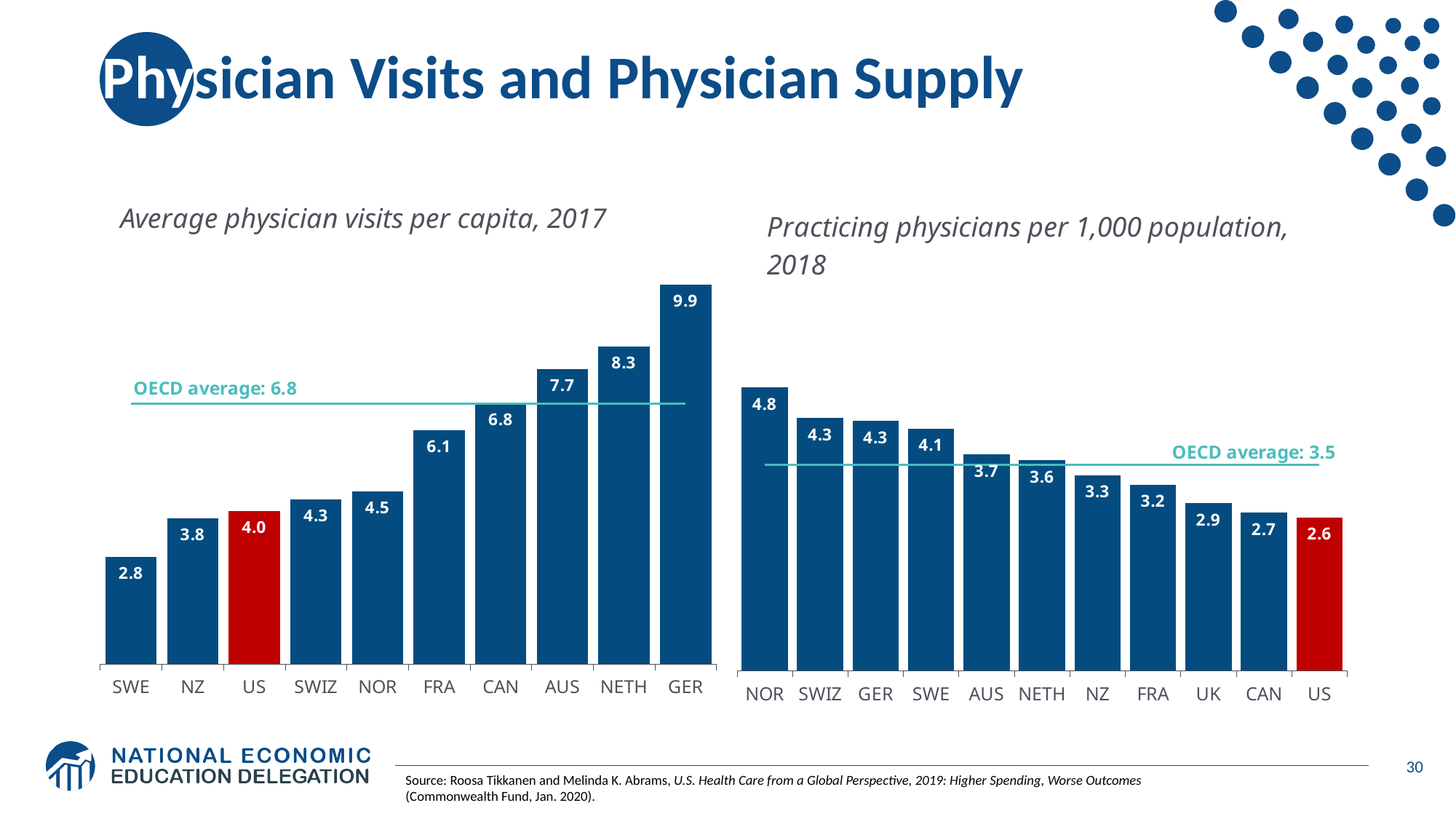
In the 'Practicing physicians per 1,000 population, 2018' chart, do the values rise or fall from left to right? Fall In the 'Average physician visits per capita, 2017' chart, which is larger, the value for FRA or the value for NOR? FRA How many countries are shown in the 'Average physician visits per capita, 2017' chart? 10 What OECD average is marked on the 'Average physician visits per capita, 2017' chart? 6.8 In the 'Average physician visits per capita, 2017' chart, what is the difference between GER and US? 5.9 In the 'Practicing physicians per 1,000 population, 2018' chart, what is the value for US? 2.6 In the 'Practicing physicians per 1,000 population, 2018' chart, what is the difference between NOR and US? 2.2 In the 'Average physician visits per capita, 2017' chart, which country has the lowest value? SWE What kind of chart is the 'Average physician visits per capita, 2017' chart? Bar chart In the 'Practicing physicians per 1,000 population, 2018' chart, which country has the highest value? NOR How many countries are shown in the 'Practicing physicians per 1,000 population, 2018' chart? 11 In the 'Average physician visits per capita, 2017' chart, what is the value for GER? 9.9